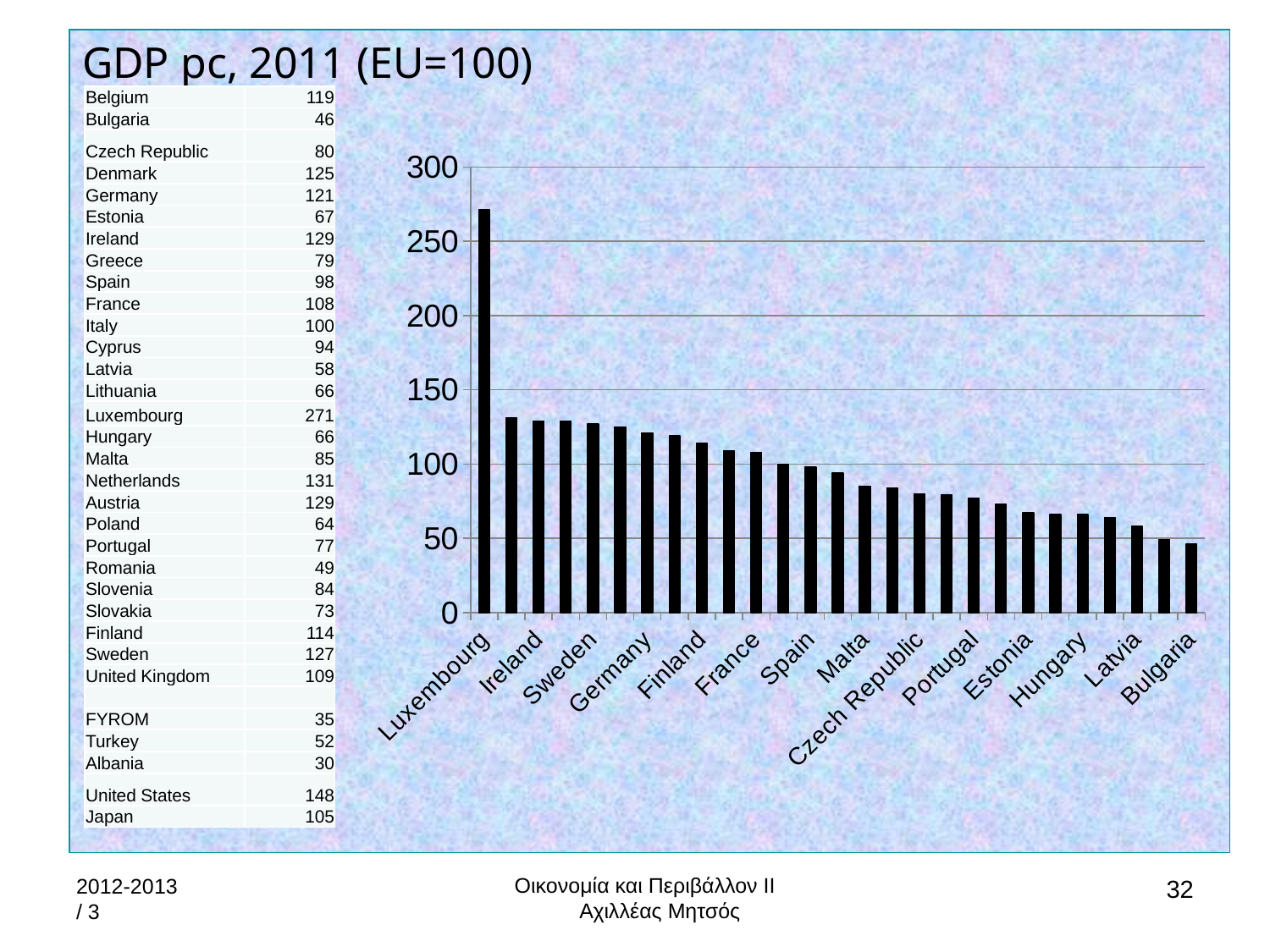
Do the bar values rise or fall from left to right along the x axis? fall What is the title of the chart on the slide? GDP pc, 2011 (EU=100) Which country has the lowest bar in the chart? Bulgaria What kind of chart is shown on the slide? bar chart According to the table on the slide, what is the GDP per capita value for Bulgaria? 46 Is the value for Luxembourg greater or less than 250? greater Is the value for Bulgaria greater or less than 50? less Is the value for Ireland greater or less than 100? greater Which has the larger value, Germany or France? Germany Which country has the highest bar in the chart? Luxembourg According to the table on the slide, what is the GDP per capita value for Luxembourg? 271